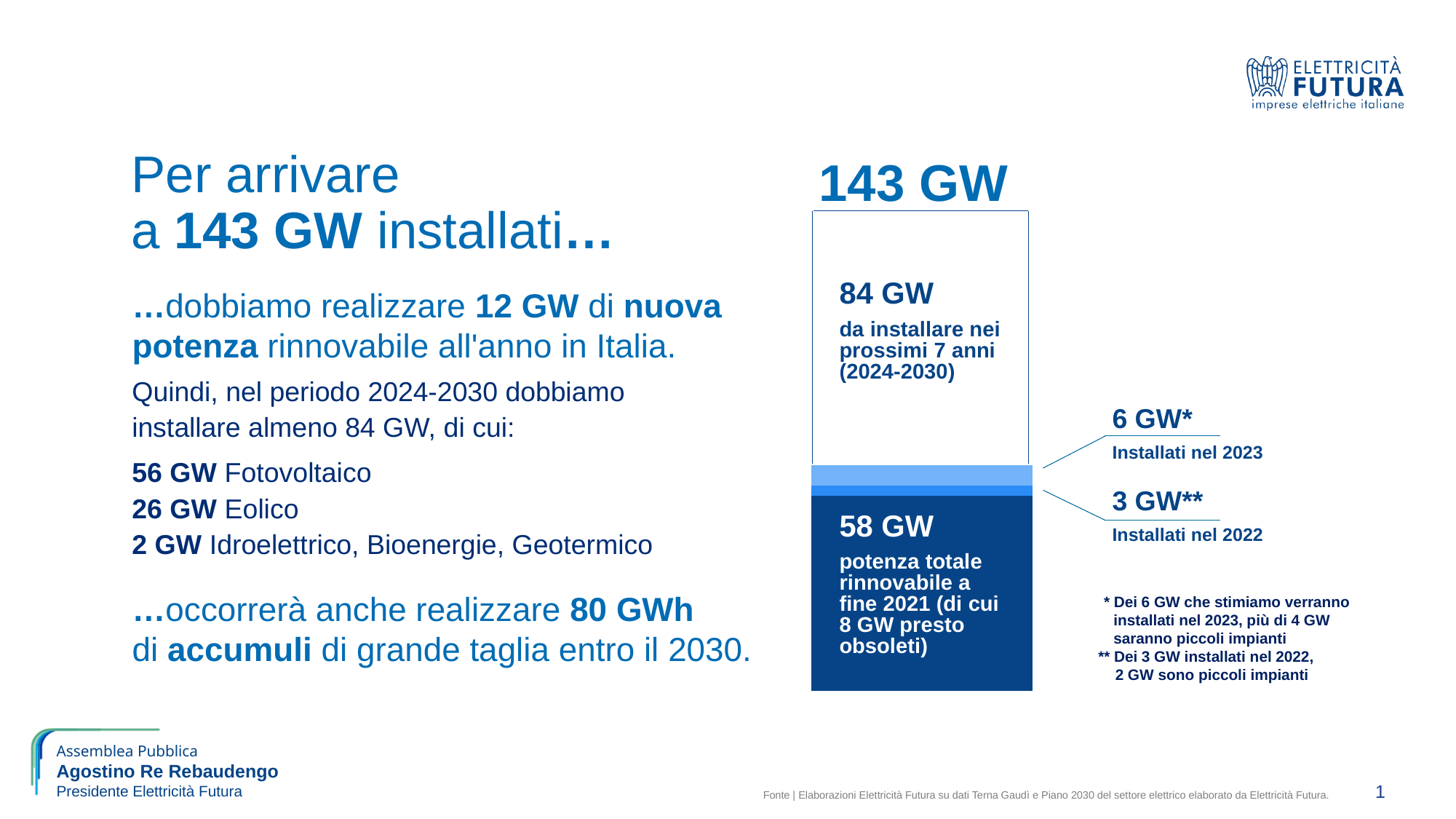
What value is given for the segment 'Installati nel 2022'? 3 GW What total value is labelled at the top of the stacked bar? 143 GW Which segment of the stacked bar has the smallest value? 3 GW Installati nel 2022 What value is given for the segment 'Installati nel 2023'? 6 GW What is the value of the segment labelled 'da installare nei prossimi 7 anni (2024-2030)'? 84 GW What is the value of the segment labelled 'potenza totale rinnovabile a fine 2021'? 58 GW What is the difference between the 84 GW segment and the 58 GW segment? 26 GW Which is larger: the capacity installed in 2023 or the capacity installed in 2022? Installati nel 2023 (6 GW) What type of chart is shown on the slide? bar chart Which segment of the stacked bar is drawn in the darkest blue? 58 GW potenza totale rinnovabile a fine 2021 Which segment of the stacked bar has the largest value? 84 GW da installare nei prossimi 7 anni (2024-2030) How many segments make up the stacked bar? 4